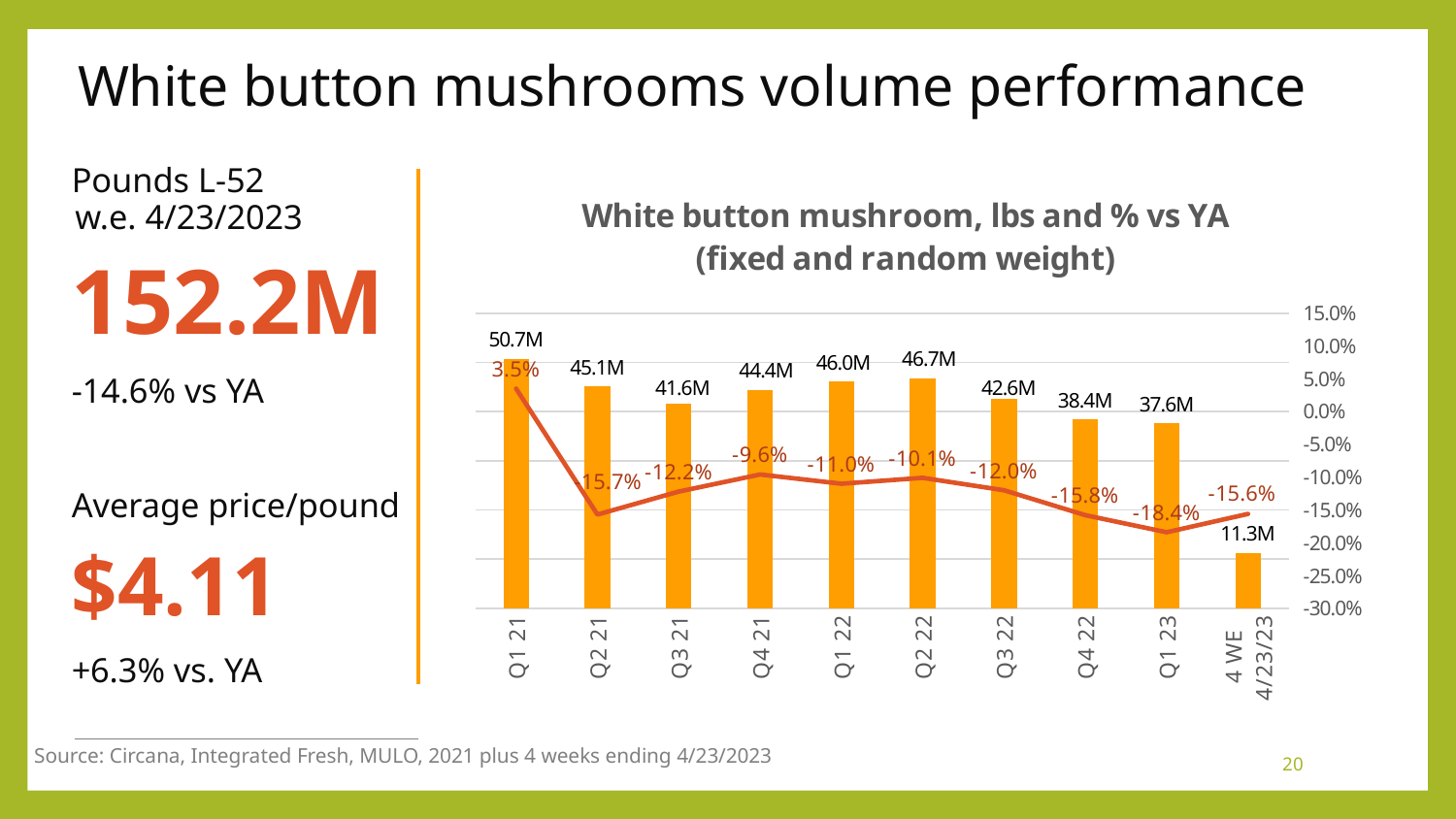
What is the % vs YA value for Q4 21? -9.6% Which period has the highest pounds bar? Q1 21 What is the pounds value for Q1 21? 50.7M Which has the larger pounds value, Q3 21 or Q4 21? Q4 21 What kind of chart is shown? Combination bar and line chart What is the difference in pounds between Q2 22 and Q1 22? 0.7M How many periods are shown on the x axis? 10 What is the % vs YA value for Q1 23? -18.4% Do the pounds bars rise or fall from Q2 22 through 4 WE 4/23/23? Fall Which period has the lowest pounds bar? 4 WE 4/23/23 What is the pounds value for the 4 WE 4/23/23 period? 11.3M Which period has the lowest % vs YA value on the line? Q1 23